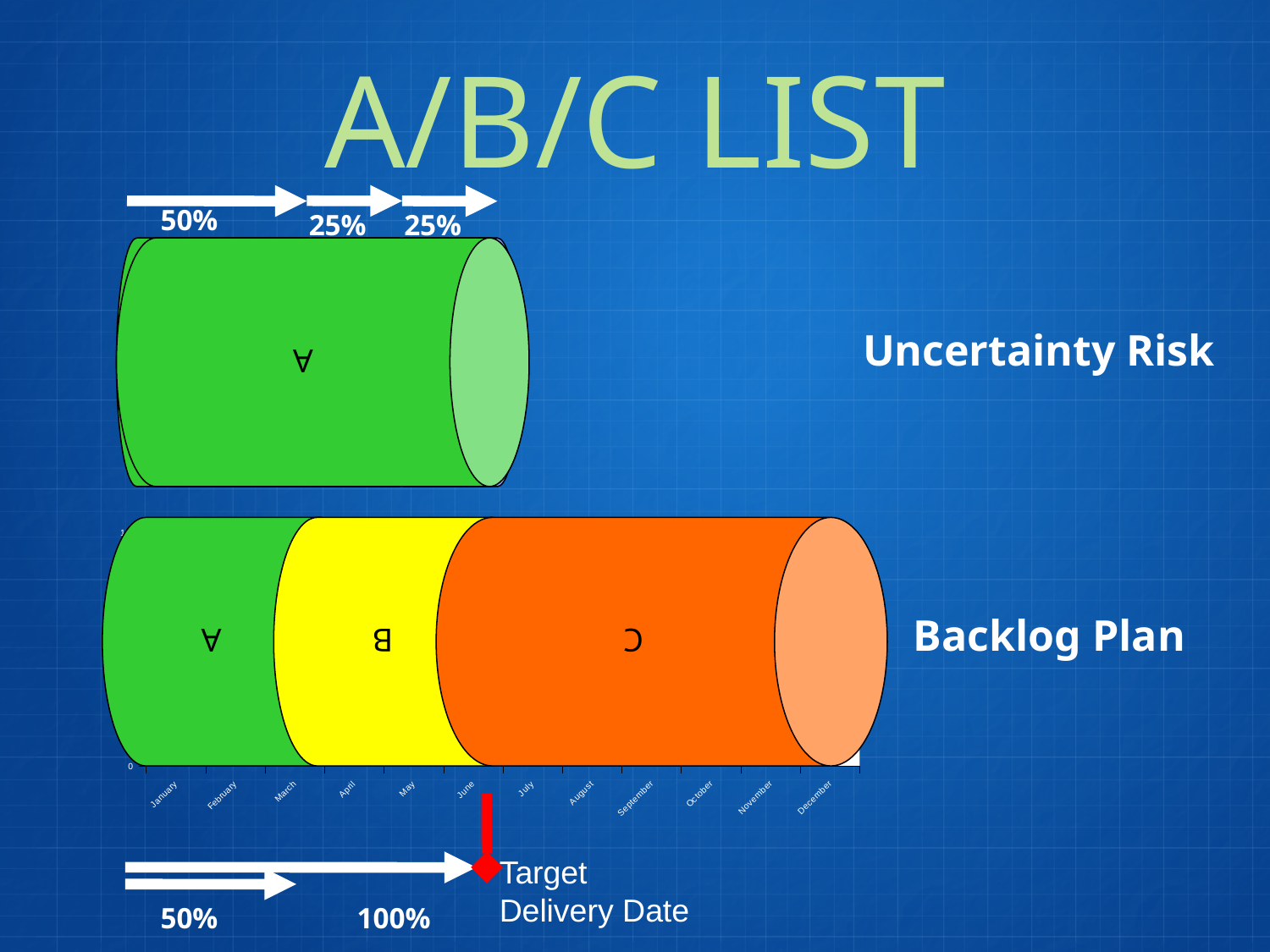
Which segment of the Backlog Plan bar is the longest? C How many segments (A, B, C) make up the Backlog Plan bar? 3 What is the first month label on the x axis of the Backlog Plan chart? January How many month labels are shown on the x axis of the Backlog Plan chart? 12 Which segment label appears on the single cylinder in the Uncertainty Risk chart? A What colour is segment B in the Backlog Plan bar? yellow In the Backlog Plan chart, which segment is longer, A or C? C What colour is segment C in the Backlog Plan bar? orange What is the last month label on the x axis of the Backlog Plan chart? December What type of chart is used for the Backlog Plan? bar chart